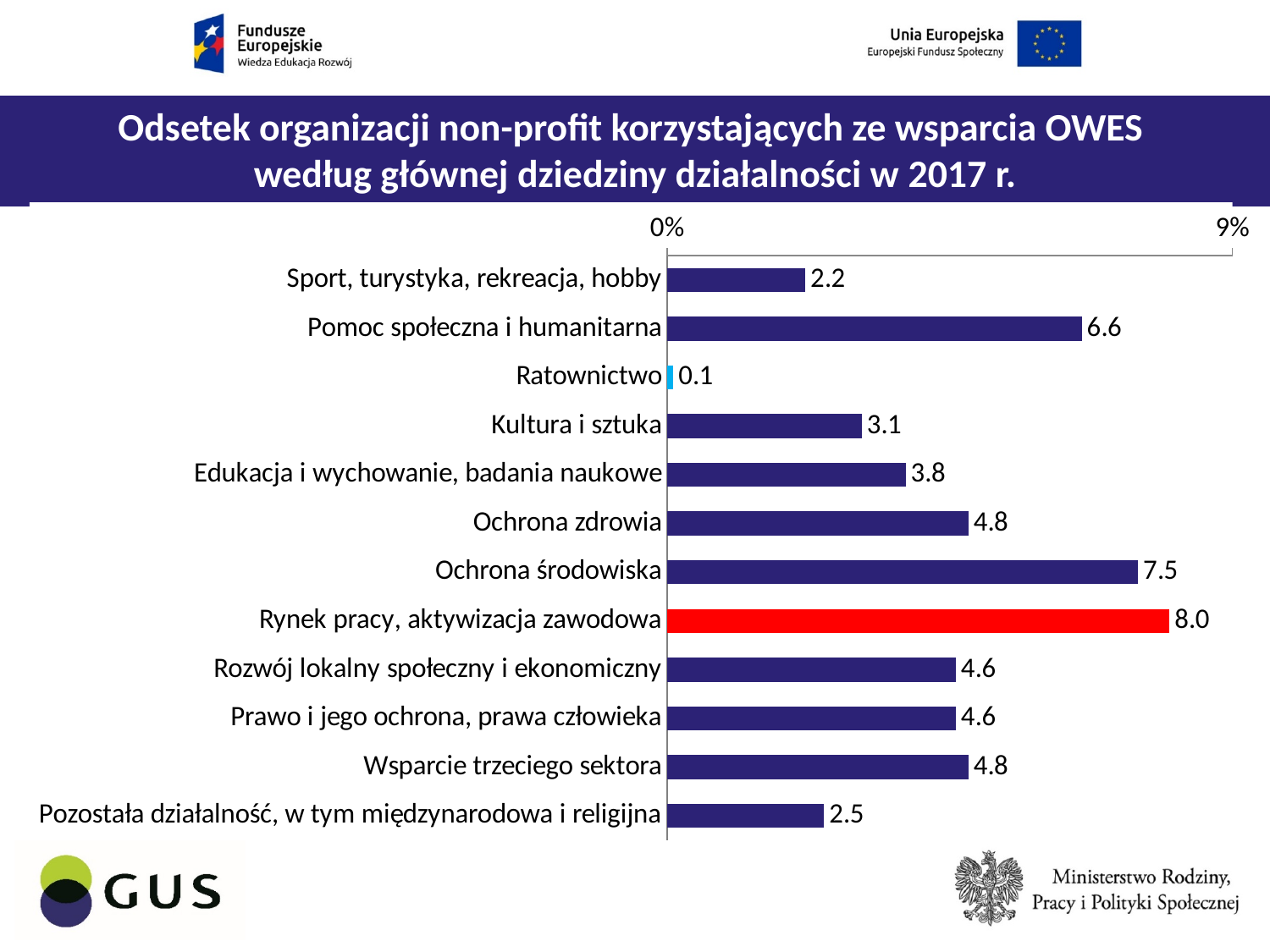
Which bar is coloured red in the chart? Rynek pracy, aktywizacja zawodowa What kind of chart is shown on the slide? Bar chart What is the difference between the values for Rynek pracy, aktywizacja zawodowa and Sport, turystyka, rekreacja, hobby? 5.8 What is the value for Pozostała działalność, w tym międzynarodowa i religijna? 2.5 What is the value for Rynek pracy, aktywizacja zawodowa? 8.0 What is the value for Ratownictwo? 0.1 Which is larger, the value for Edukacja i wychowanie, badania naukowe or the value for Ochrona zdrowia? Ochrona zdrowia Which category has the highest value? Rynek pracy, aktywizacja zawodowa How many categories are shown in the chart? 12 What is the value for Pomoc społeczna i humanitarna? 6.6 Which category has the lowest value? Ratownictwo What is the difference between the values for Ochrona środowiska and Kultura i sztuka? 4.4